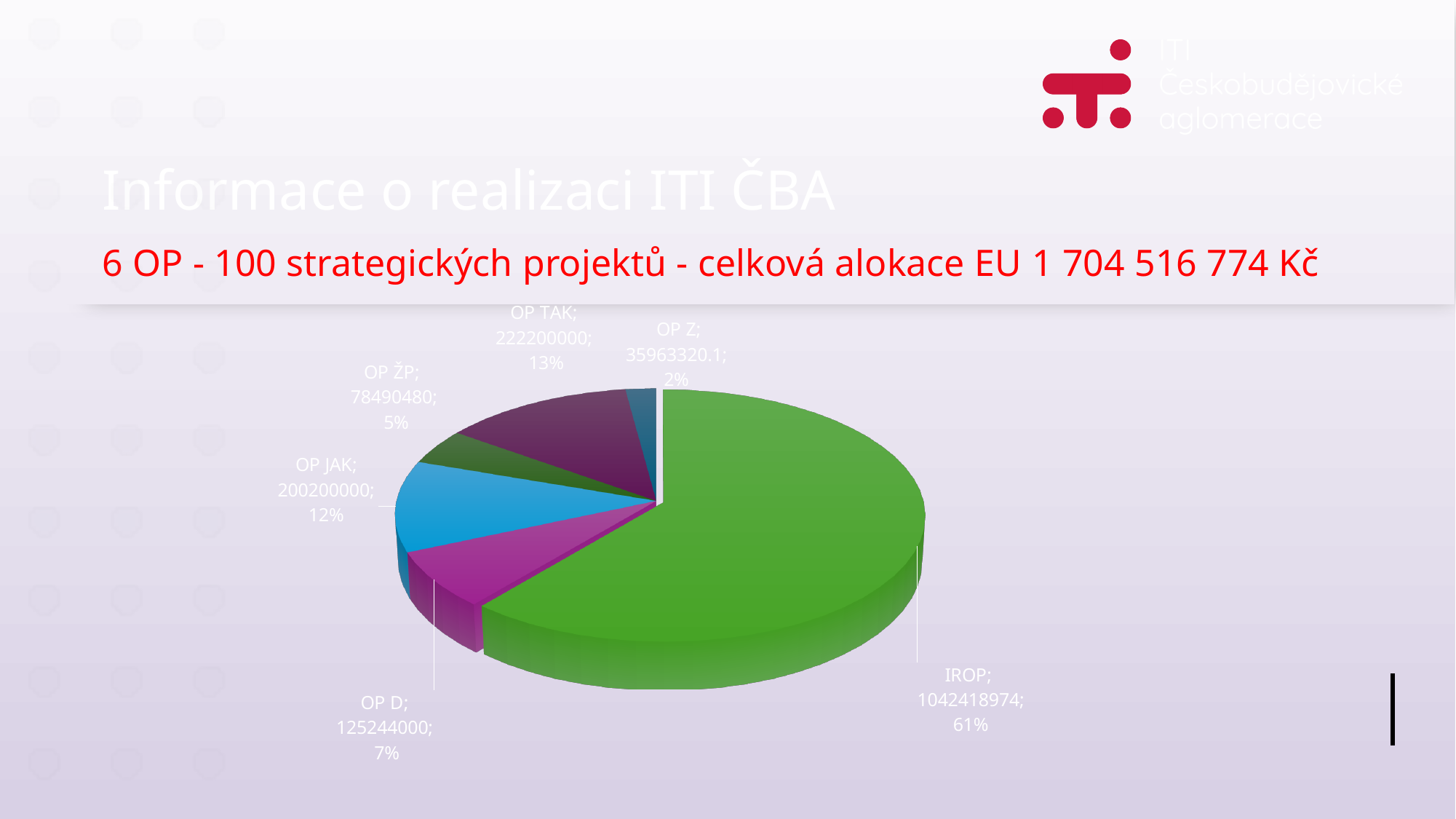
What kind of chart is shown on the slide? pie chart What is the value shown for IROP? 1042418974 What percentage share does OP D have? 7% What is the value shown for OP TAK? 222200000 Which category has the smallest slice of the pie? OP Z What is the difference between the values for OP TAK and OP JAK? 22000000 What percentage share does IROP have in the pie chart? 61% What percentage share does OP JAK have? 12% What is the value shown for OP Z? 35963320.1 Which category has the largest slice of the pie? IROP Which is larger, the value for OP TAK or the value for OP JAK? OP TAK How many slices does the pie chart have? 6